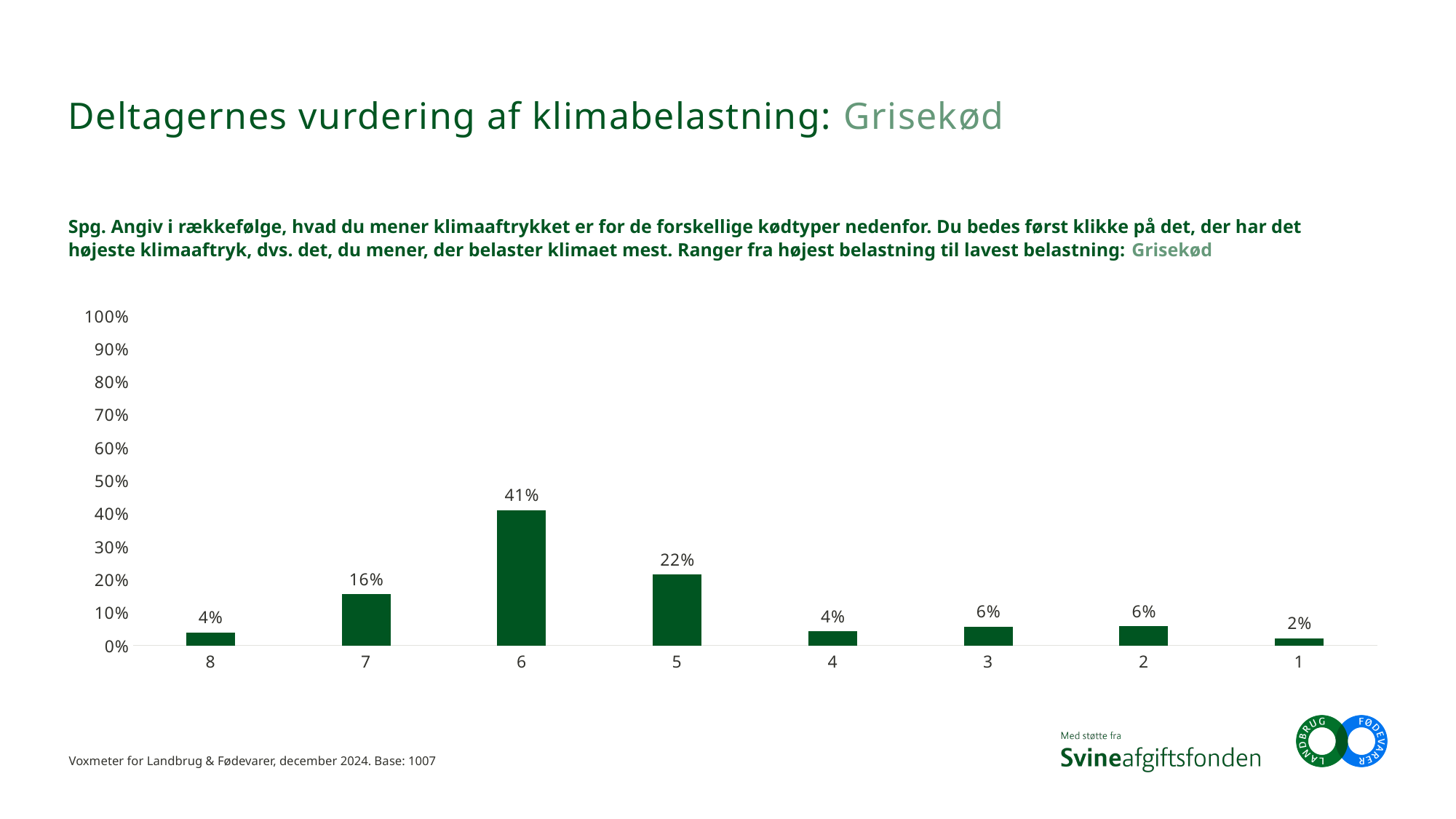
What is the title of the slide? Deltagernes vurdering af klimabelastning: Grisekød What kind of chart is shown on the slide? bar chart What is the value for category 7? 16% How many categories are shown on the x axis? 8 What is the difference between the values for category 6 and category 5? 19% Which category has the lowest value? 1 What is the value for category 5? 22% What is the value for category 1? 2% Which is larger, the value for category 7 or the value for category 3? 7 Is the value for category 6 greater or less than 40%? greater Which category has the highest value? 6 What is the value for category 6? 41%